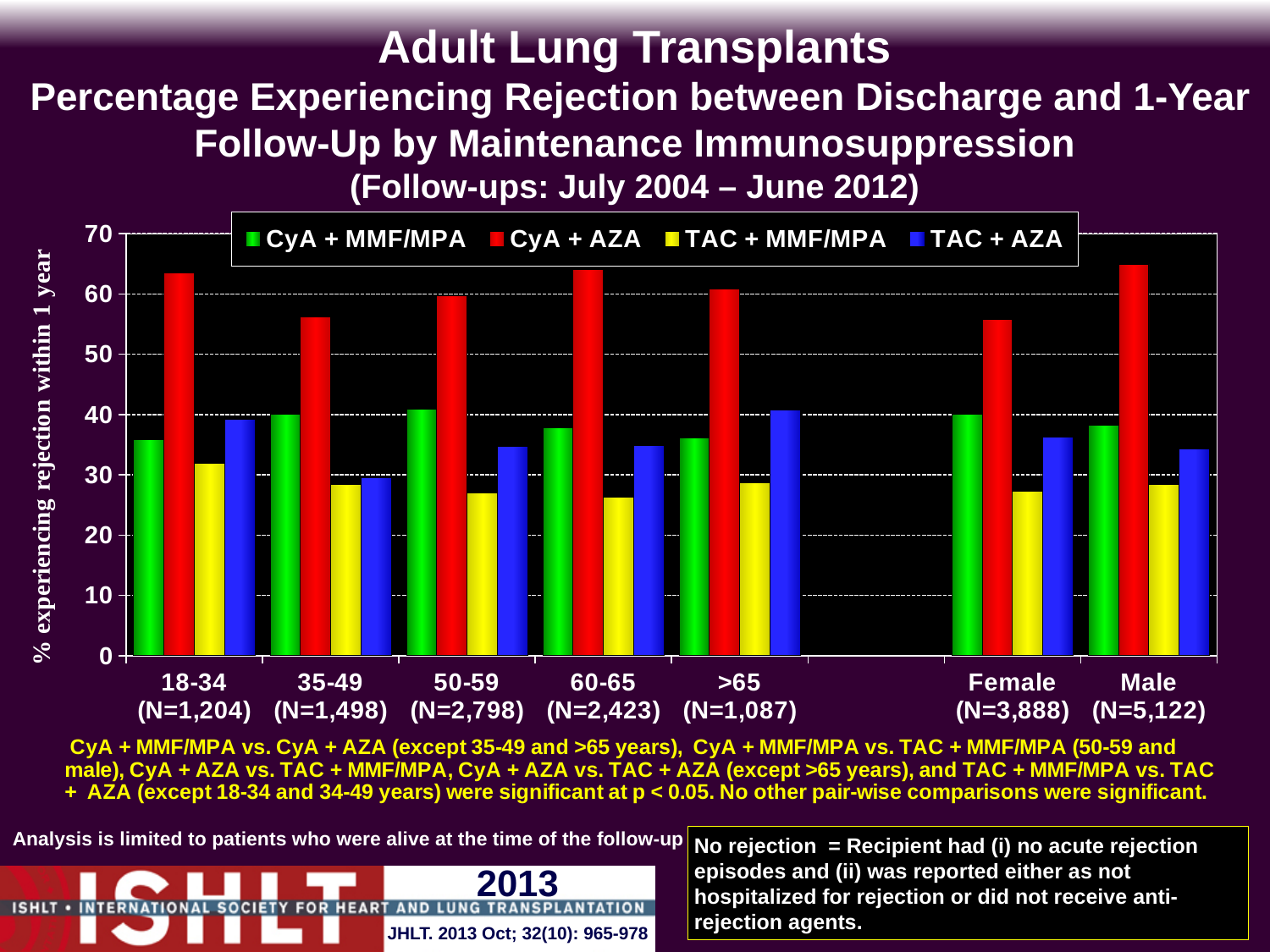
How many categories are shown along the x axis? 7 Is the value for TAC + MMF/MPA in the 50-59 age group greater or less than 30? less Is the value for CyA + AZA in the 18-34 age group greater or less than 60? greater Is the value for CyA + AZA for Male greater or less than 60? greater What kind of chart is shown on the slide? bar chart What colour represents CyA + AZA in the legend? red How many series does the legend list? 4 Which maintenance immunosuppression series has the highest value in the 18-34 age group? CyA + AZA In the 35-49 age group, which is larger: CyA + MMF/MPA or TAC + AZA? CyA + MMF/MPA Which series has the highest value in every category shown? CyA + AZA Which is larger: TAC + AZA for the >65 age group or TAC + AZA for the 35-49 age group? >65 Which maintenance immunosuppression series has the lowest value in the 60-65 age group? TAC + MMF/MPA